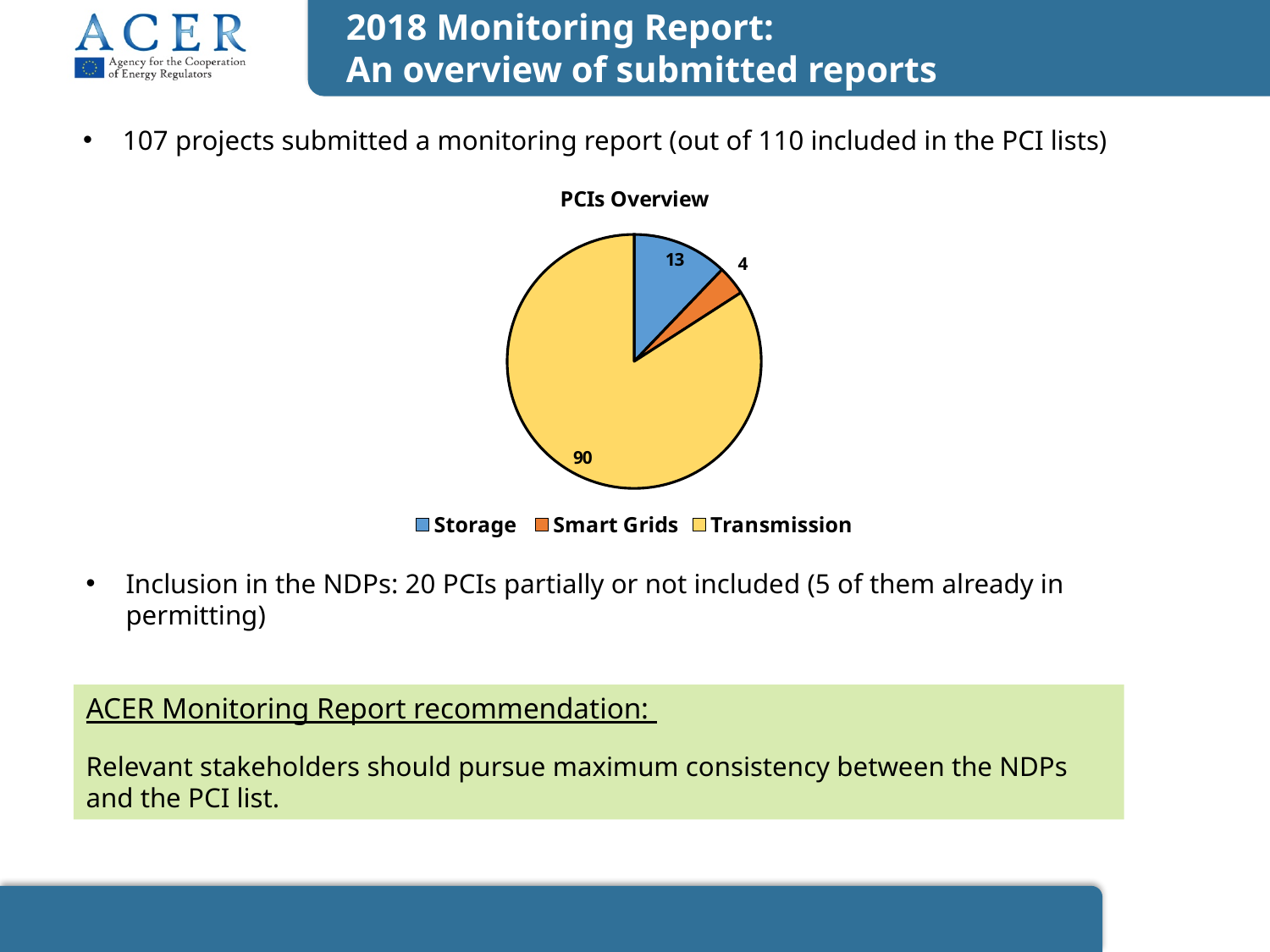
Which is larger, the value for Storage or the value for Smart Grids? Storage How many categories does the pie chart show? 3 What is the total of all slices in the pie chart? 107 What is the title of the chart? PCIs Overview What kind of chart is shown on the slide? pie chart What is the value for Transmission in the pie chart? 90 What is the value for Smart Grids in the pie chart? 4 What is the value for Storage in the pie chart? 13 Which colour represents Transmission in the pie chart? yellow Which category has the largest slice of the pie? Transmission Which category has the smallest slice of the pie? Smart Grids What is the difference between the Transmission and Storage values? 77